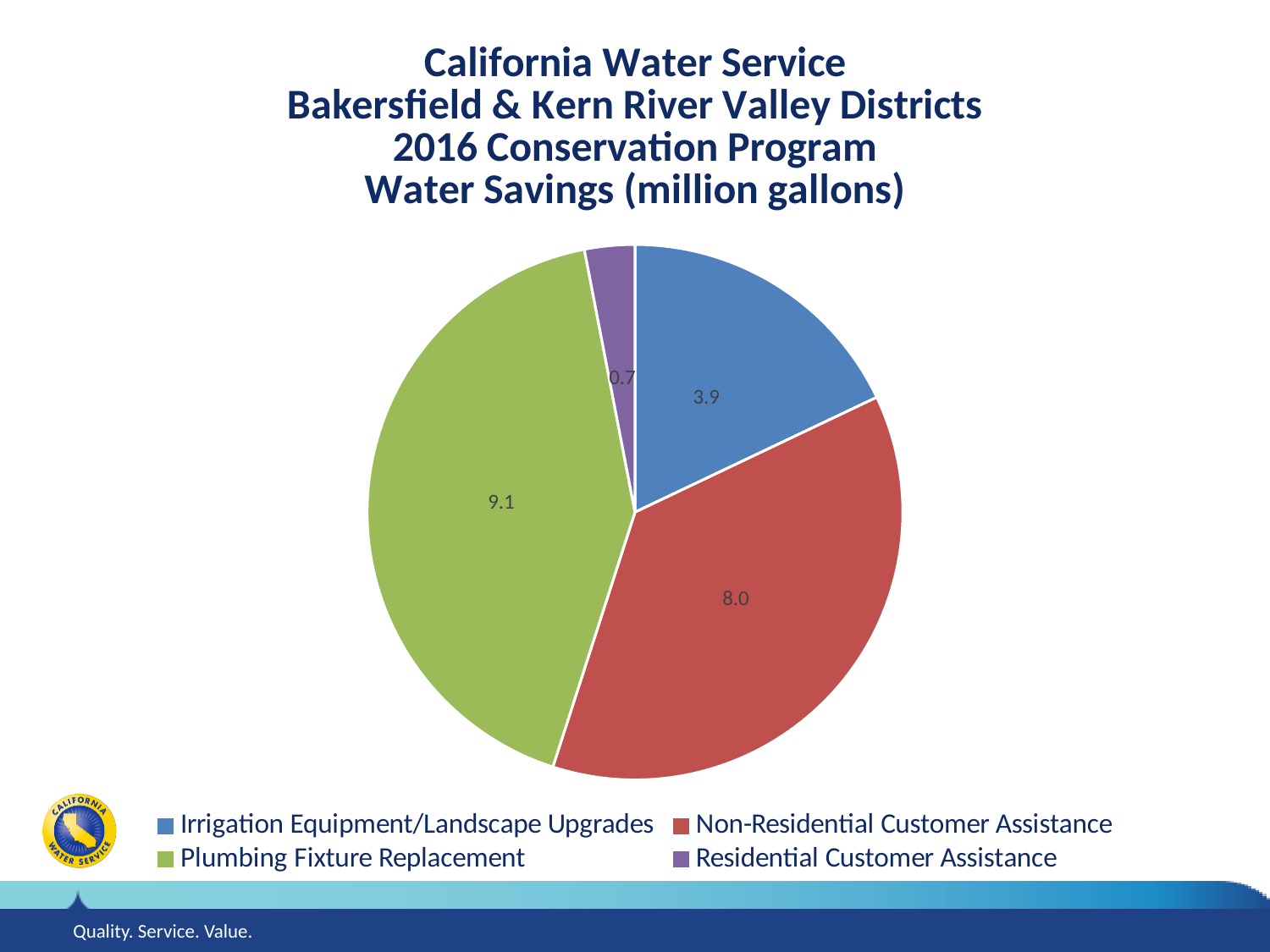
What is the difference in water savings between Plumbing Fixture Replacement and Non-Residential Customer Assistance? 1.1 What is the water savings value for Residential Customer Assistance? 0.7 What is the water savings value for Plumbing Fixture Replacement? 9.1 Which has greater water savings, Irrigation Equipment/Landscape Upgrades or Non-Residential Customer Assistance? Non-Residential Customer Assistance How many categories are shown in the pie chart? 4 Which colour represents Plumbing Fixture Replacement in the pie chart? Green What is the water savings value for Non-Residential Customer Assistance? 8.0 What is the water savings value for Irrigation Equipment/Landscape Upgrades? 3.9 Which category has the smallest water savings? Residential Customer Assistance Which category has the largest water savings? Plumbing Fixture Replacement What type of chart is shown on the slide? Pie chart What is the total water savings across all four categories? 21.7